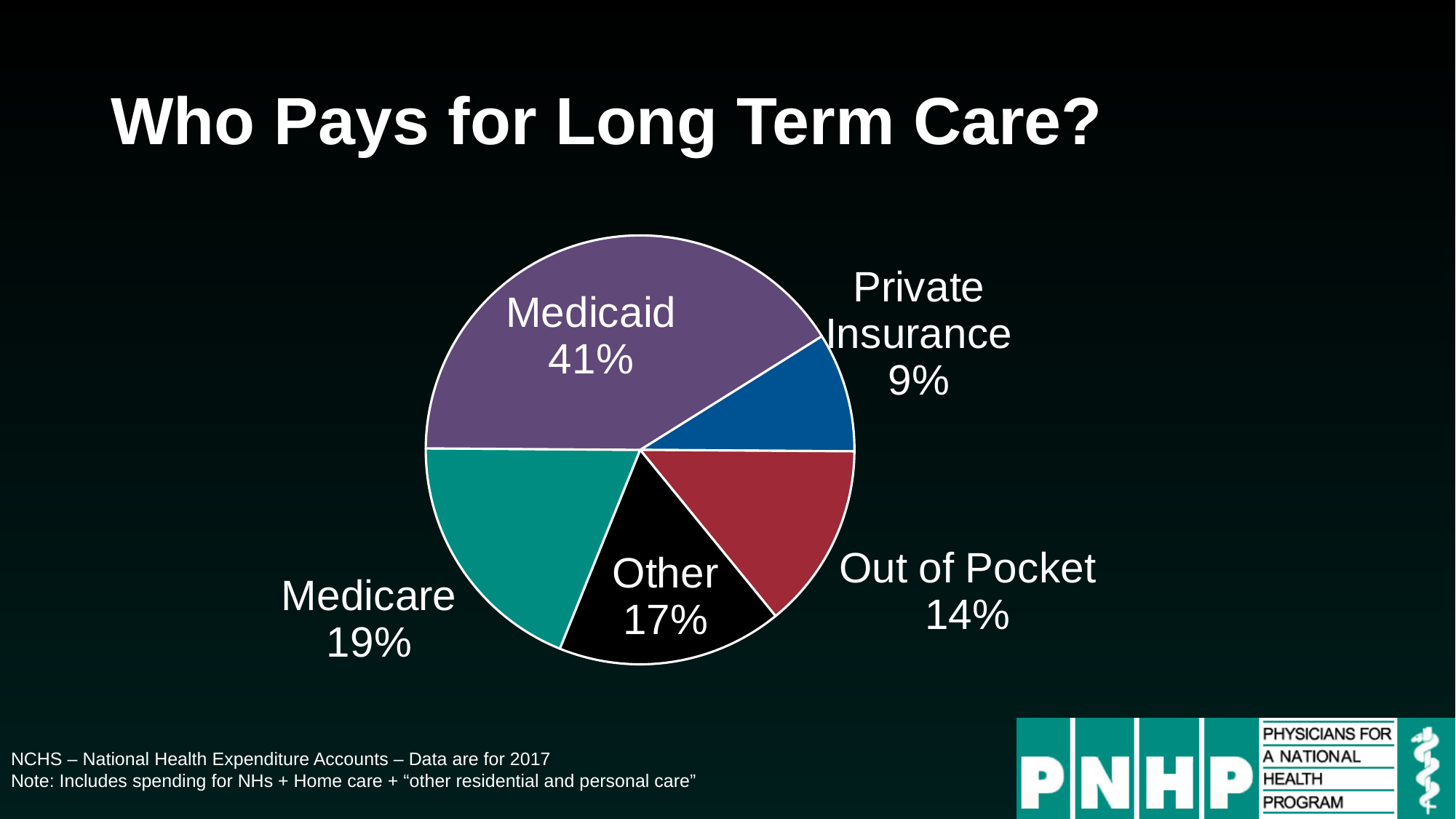
How many slices does the pie chart have? 5 Which is larger, the Medicare share or the Other share? Medicare What share of long term care spending is paid by Medicare? 19% Which payer has the smallest share of long term care spending? Private Insurance What share of long term care spending is paid out of pocket? 14% Which payer has the largest share of long term care spending? Medicaid What share of long term care spending is paid by Medicaid? 41% What share of long term care spending is paid by private insurance? 9% What is the title of the slide? Who Pays for Long Term Care? What is the difference in percentage points between the Out of Pocket share and the Private Insurance share? 5 How many percentage points larger is Medicaid's share than Medicare's share? 22 What kind of chart is shown on the slide? Pie chart